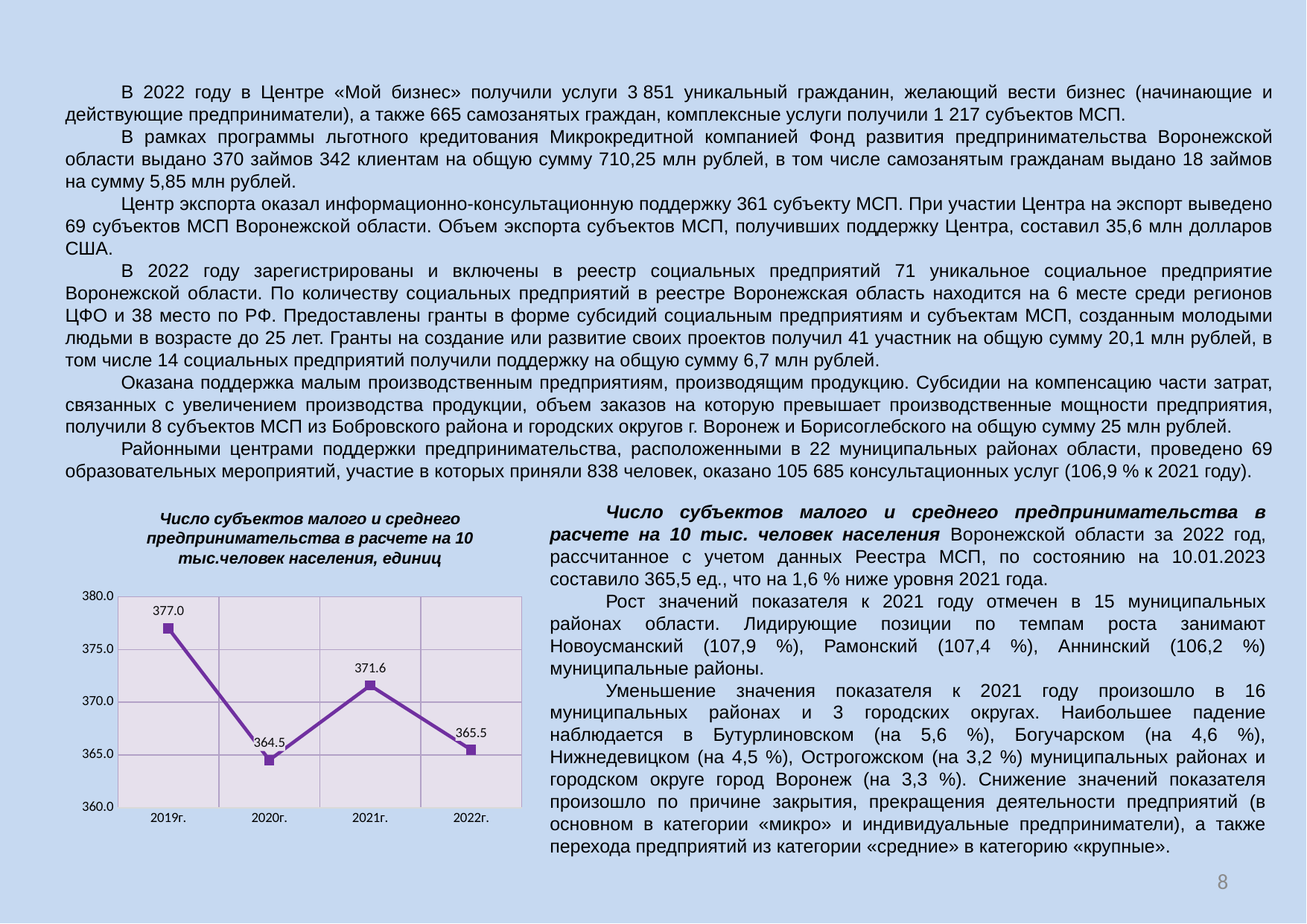
What is the value for 2020г. on the chart? 364.5 Which year has the highest value on the chart? 2019г. Which is larger, the value for 2021г. or the value for 2022г.? 2021г. Is the value for 2019г. greater or less than 375.0? greater What is the value for 2022г. on the chart? 365.5 What is the difference between the values for 2021г. and 2022г.? 6.1 Which year has the lowest value on the chart? 2020г. How many years are plotted on the chart? 4 What is the value for 2021г. on the chart? 371.6 What kind of chart is shown on the slide? line chart What is the value for 2019г. on the chart? 377.0 What is the difference between the values for 2019г. and 2020г.? 12.5